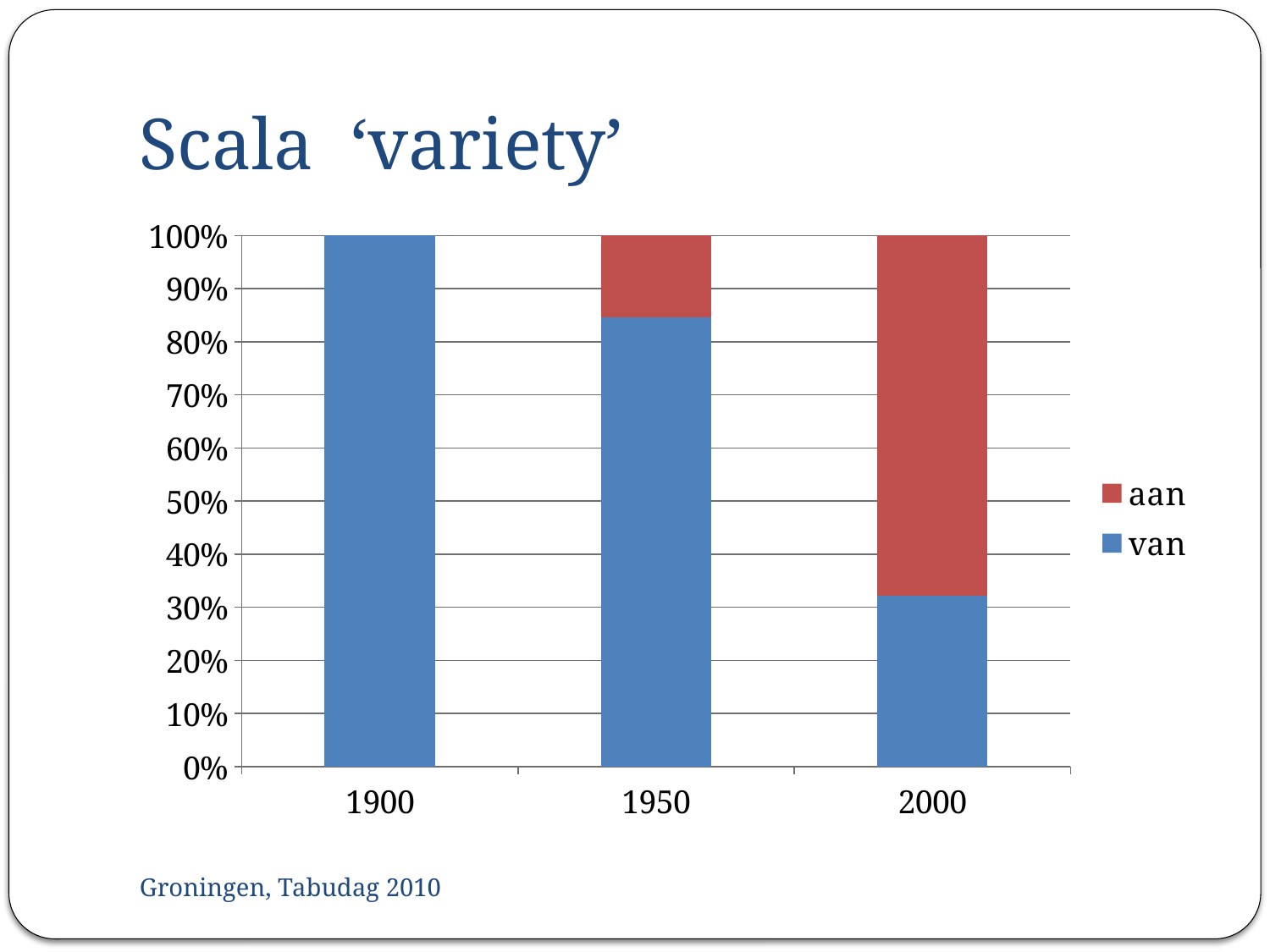
Is the value for 'van' in 2000 greater or less than 40%? less Is the value for 'van' in 1950 greater or less than 80%? greater In which year is the share of 'van' the lowest? 2000 What kind of chart is shown on the slide? stacked bar chart How many series does the legend list? 2 What is the value for 'van' in 1900? 100% In which year is the share of 'aan' the highest? 2000 Which colour represents the 'aan' series in the legend? red Is the share of 'aan' in 2000 greater or less than 60%? greater Does the share of 'van' rise or fall from 1900 to 2000? fall How many categories are shown on the x axis? 3